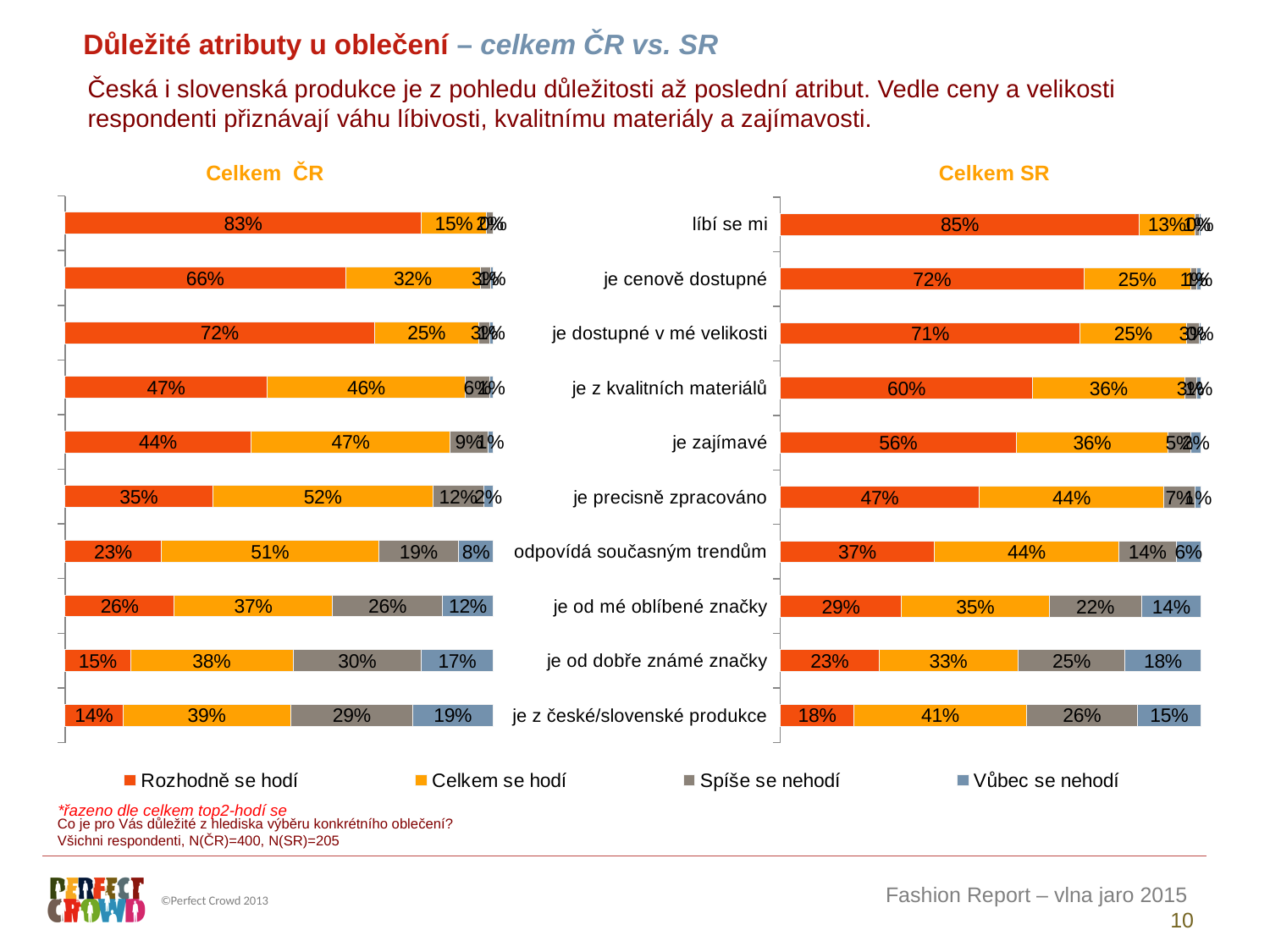
In the Celkem ČR chart, which attribute has the lowest 'Rozhodně se hodí' value? je z české/slovenské produkce In the Celkem ČR chart, what is the total of the four segments for 'je od dobře známé značky'? 100% What type of chart is the Celkem SR chart? Stacked bar chart How many series does the legend list? 4 How many attributes (categories) are shown in the Celkem ČR chart? 10 In the Celkem SR chart, what is the difference between the 'Rozhodně se hodí' values for 'je cenově dostupné' and 'je dostupné v mé velikosti'? 1% In the Celkem SR chart, what is the 'Celkem se hodí' value for 'je od dobře známé značky'? 33% In the Celkem ČR chart, what is the 'Vůbec se nehodí' value for 'je od mé oblíbené značky'? 12% What is the title of the chart on the right side of the slide? Celkem SR In the Celkem ČR chart, what is the 'Rozhodně se hodí' value for 'je z české/slovenské produkce'? 14% Which is larger: the 'Rozhodně se hodí' value for 'líbí se mi' in the Celkem ČR chart or in the Celkem SR chart? Celkem SR In the Celkem SR chart, which attribute has the highest 'Rozhodně se hodí' value? líbí se mi